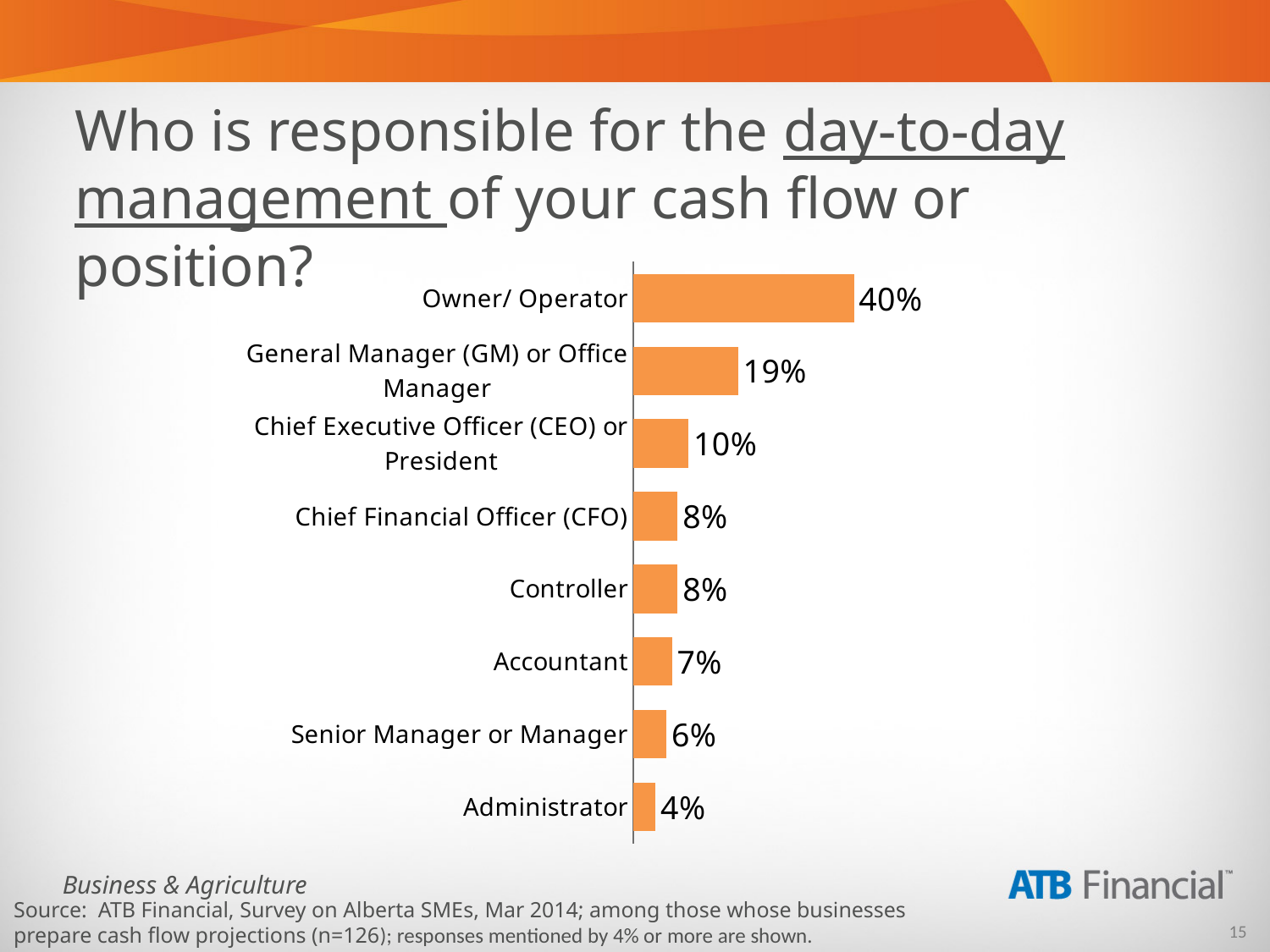
What kind of chart is shown on the slide? Bar chart Which category has the highest value in the chart? Owner/ Operator What is the value shown for Chief Executive Officer (CEO) or President? 10% What is the value shown for Administrator? 4% Which is larger, the value for Accountant or the value for Senior Manager or Manager? Accountant What is the difference between the values for Owner/ Operator and General Manager (GM) or Office Manager? 21 percentage points Which two categories share the same value of 8%? Chief Financial Officer (CFO) and Controller How many categories are shown in the chart? 8 Which category has the lowest value in the chart? Administrator What is the value shown for General Manager (GM) or Office Manager? 19% What percentage of respondents said the Owner/ Operator is responsible for day-to-day cash flow management? 40% What colour are the bars in the chart? Orange